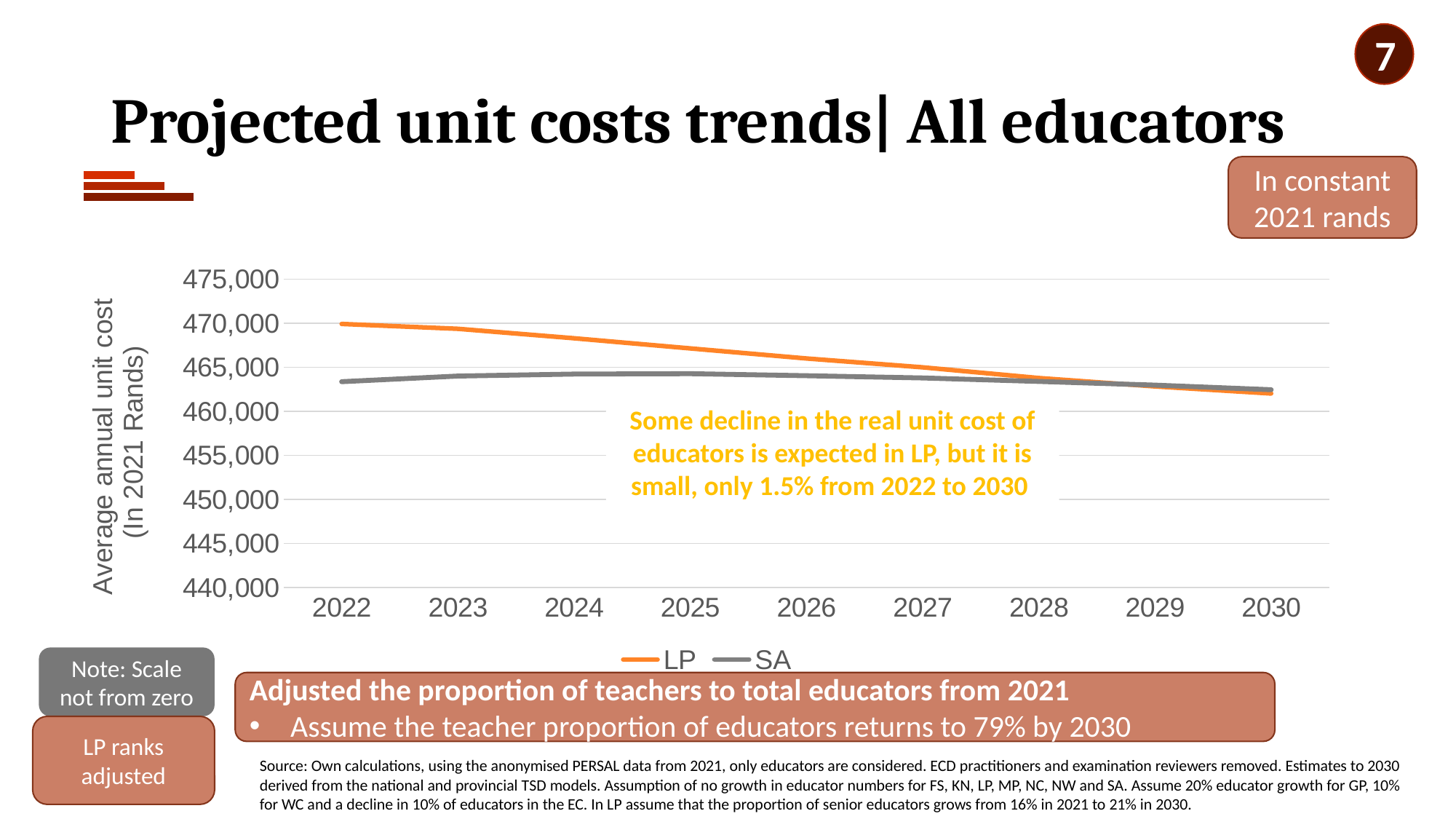
In which year is the LP series at its lowest? 2030 Is the value for SA in 2030 greater or less than 460,000? greater Is the value for LP in 2022 greater or less than 465,000? greater Does the LP line rise or fall from 2022 to 2030? fall How many years are plotted along the x axis? 9 Is the value for SA in 2022 greater or less than 465,000? less In which year is the LP series at its highest? 2022 In 2025, which series has the higher average annual unit cost, LP or SA? LP What are the two series names shown in the legend? LP and SA How many series does the legend list? 2 In 2022, which series has the higher average annual unit cost, LP or SA? LP What kind of chart is shown on the slide? line chart